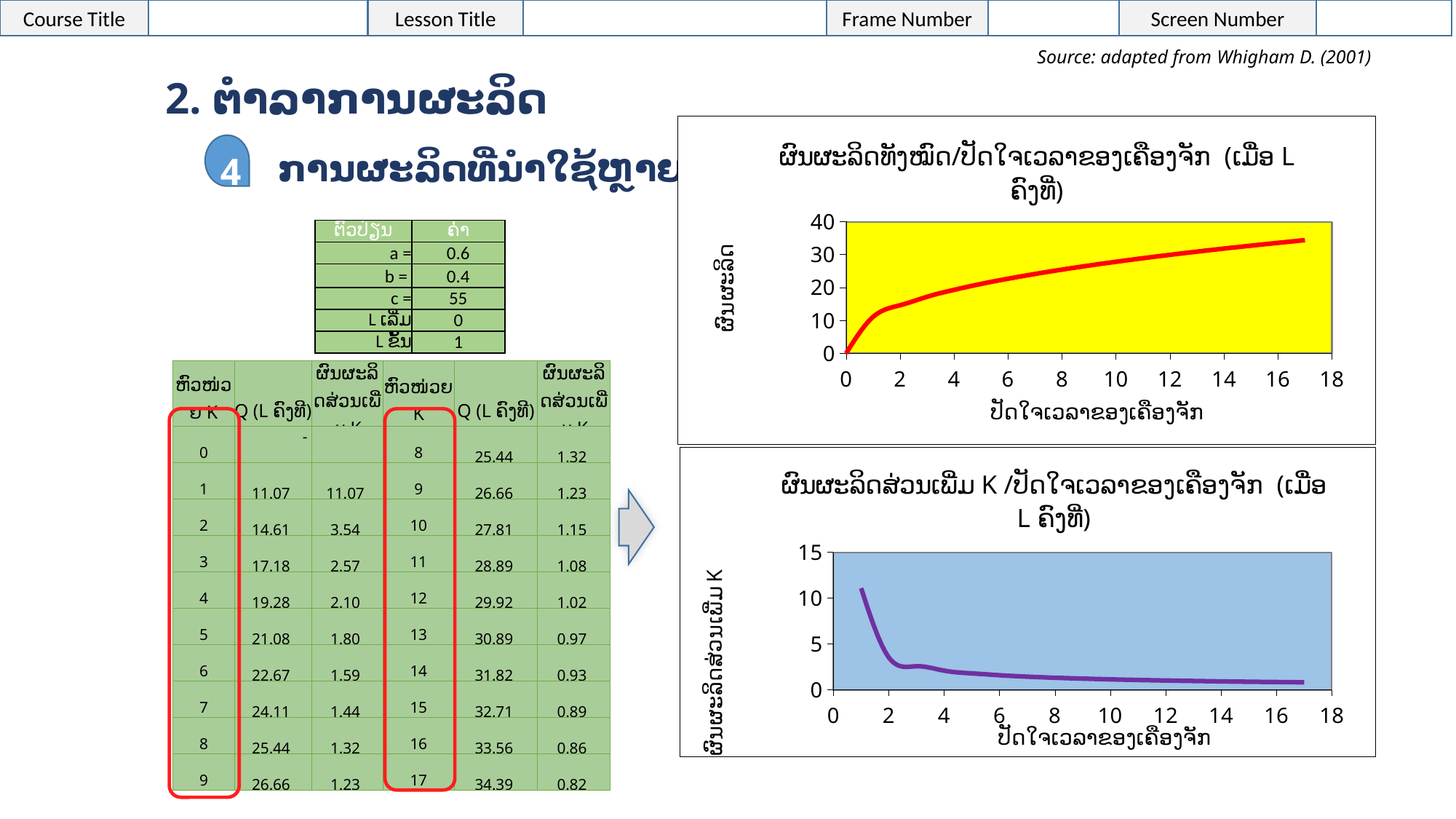
What kind of chart is the top chart (ຜົນຜະລິດທັງໝົດ/ປັດໃຈເວລາຂອງເຄື່ອງຈັກ)? line chart In the bottom chart, which is larger: the value at x = 2 or the value at x = 14? x = 2 What kind of chart is the bottom chart (ຜົນຜະລິດສ່ວນເພີ່ມ K /ປັດໃຈເວລາຂອງເຄື່ອງຈັກ)? line chart What is the highest value shown on the y axis of the bottom chart? 15 In the bottom chart, is the value at x = 10 greater or less than 5? less In the top chart, which is larger: the value at x = 4 or the value at x = 12? x = 12 What colour is the line in the top chart? red In the bottom chart, do the values rise or fall as the x axis increases? fall In the top chart, is the value at x = 16 greater or less than 30? greater In the bottom chart, is the value at x = 1 greater or less than 10? greater In the top chart, do the values rise or fall as the x axis increases? rise